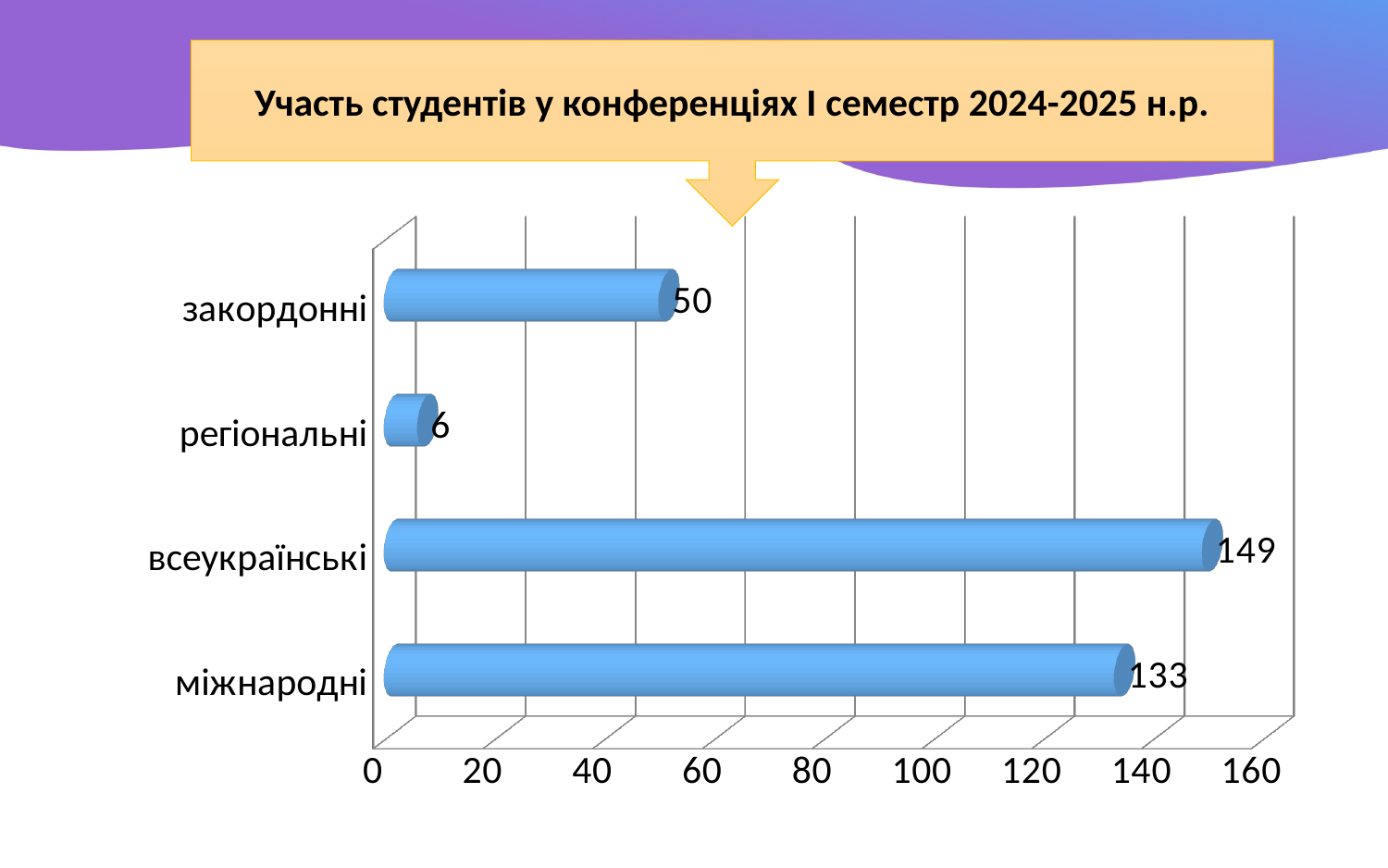
What is the difference between the values for всеукраїнські and міжнародні? 16 Which category has the lowest value? регіональні How many categories are shown in the chart? 4 What is the value for регіональні? 6 Which is larger, the value for міжнародні or the value for закордонні? міжнародні Which category has the highest value? всеукраїнські What kind of chart is shown on the slide? bar chart What is the title shown above the chart? Участь студентів у конференціях І семестр 2024-2025 н.р. What is the value for закордонні? 50 What is the value for міжнародні? 133 What is the value for всеукраїнські? 149 What is the difference between the values for закордонні and регіональні? 44